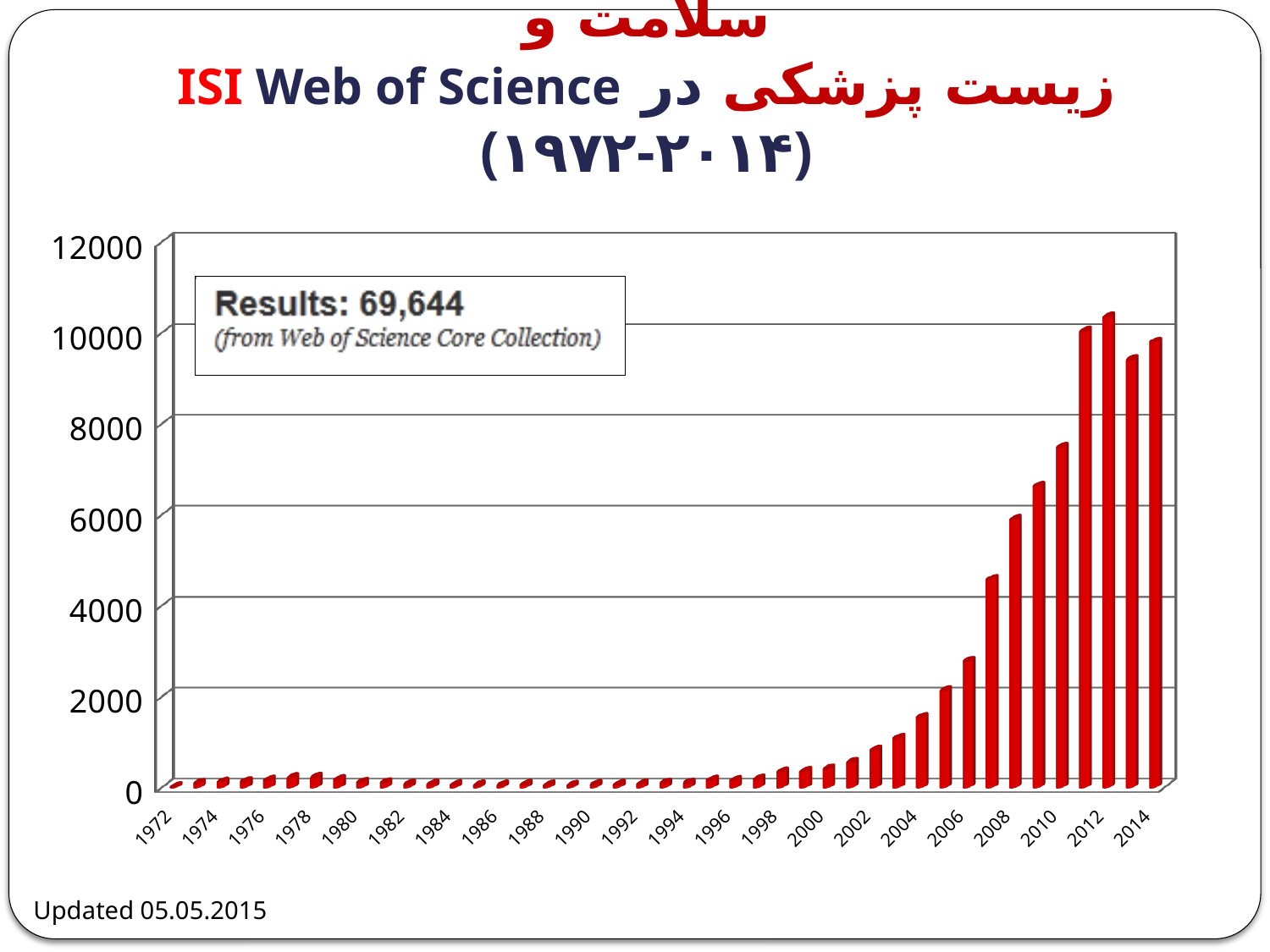
Is the value for 2012 greater or less than 10000? greater Is the value for 2010 greater or less than 8000? less Is the value for 2004 greater or less than 2000? less Which year has the highest bar in the chart? 2012 What kind of chart is shown on the slide? bar chart Do the values generally rise or fall from 1972 to 2014? rise What is the highest value shown on the vertical axis of the chart? 12000 Which year has the larger value, 2012 or 2013? 2012 Which year has the larger value, 2008 or 2010? 2010 What is the total number of results stated in the box inside the chart? 69,644